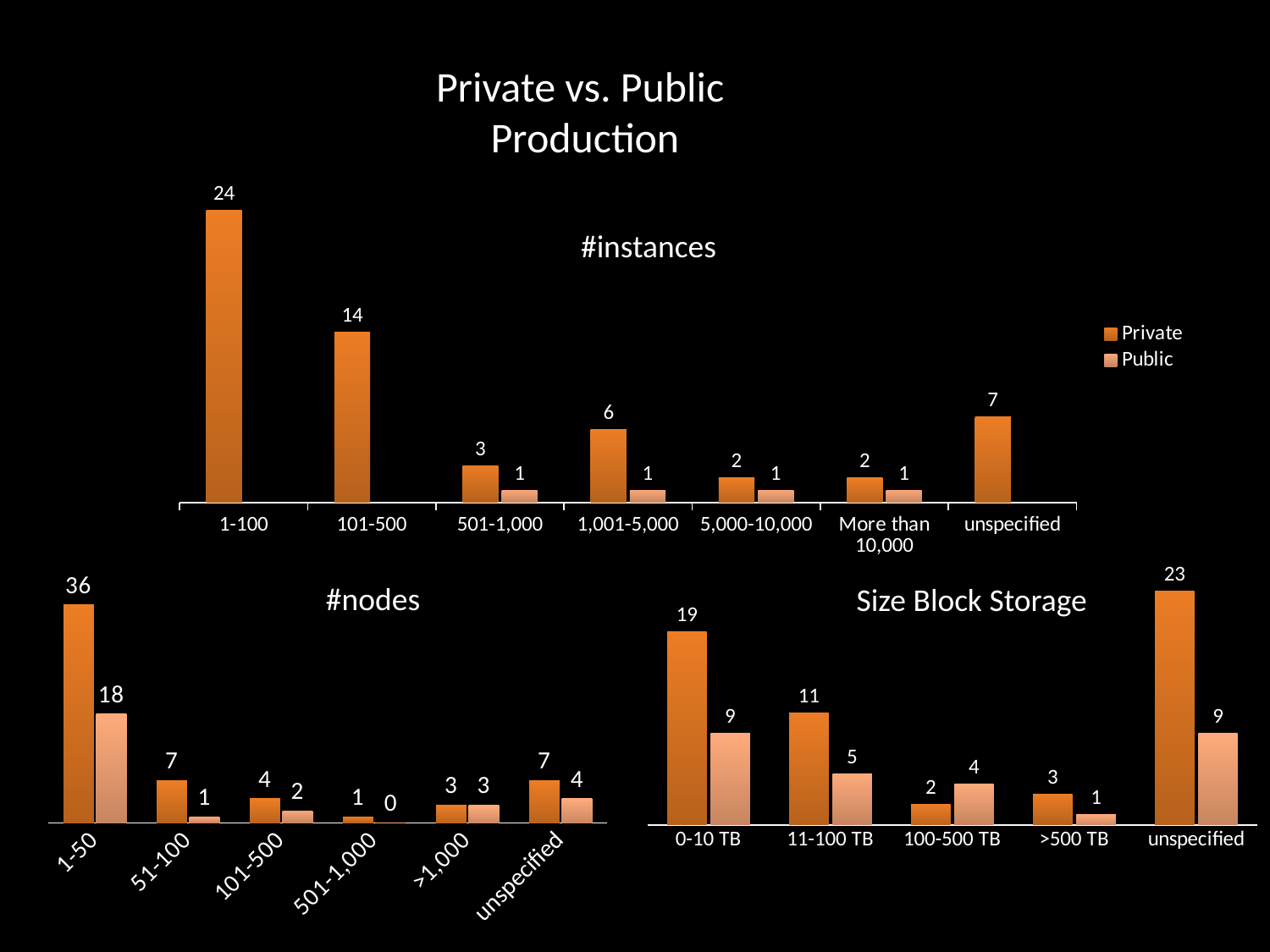
What type of chart is the Size Block Storage chart? Bar chart In the Size Block Storage chart, what is the difference between the Private and Public values for 0-10 TB? 10 In the #instances chart, what is the difference between the Private values for 1-100 and 101-500? 10 In the #instances chart, which category has the highest Private value? 1-100 In the Size Block Storage chart, which category has the lowest Public value? >500 TB In the #instances chart, what is the Private value for the 1-100 category? 24 In the #nodes chart, how many categories are shown on the x axis? 6 In the #nodes chart, which is larger for the unspecified category, Private or Public? Private In the #nodes chart, what is the Public value for the 501-1,000 category? 0 In the Size Block Storage chart, what is the Private value for the unspecified category? 23 How many series does the legend list? 2 In the #nodes chart, what is the Public value for the 1-50 category? 18